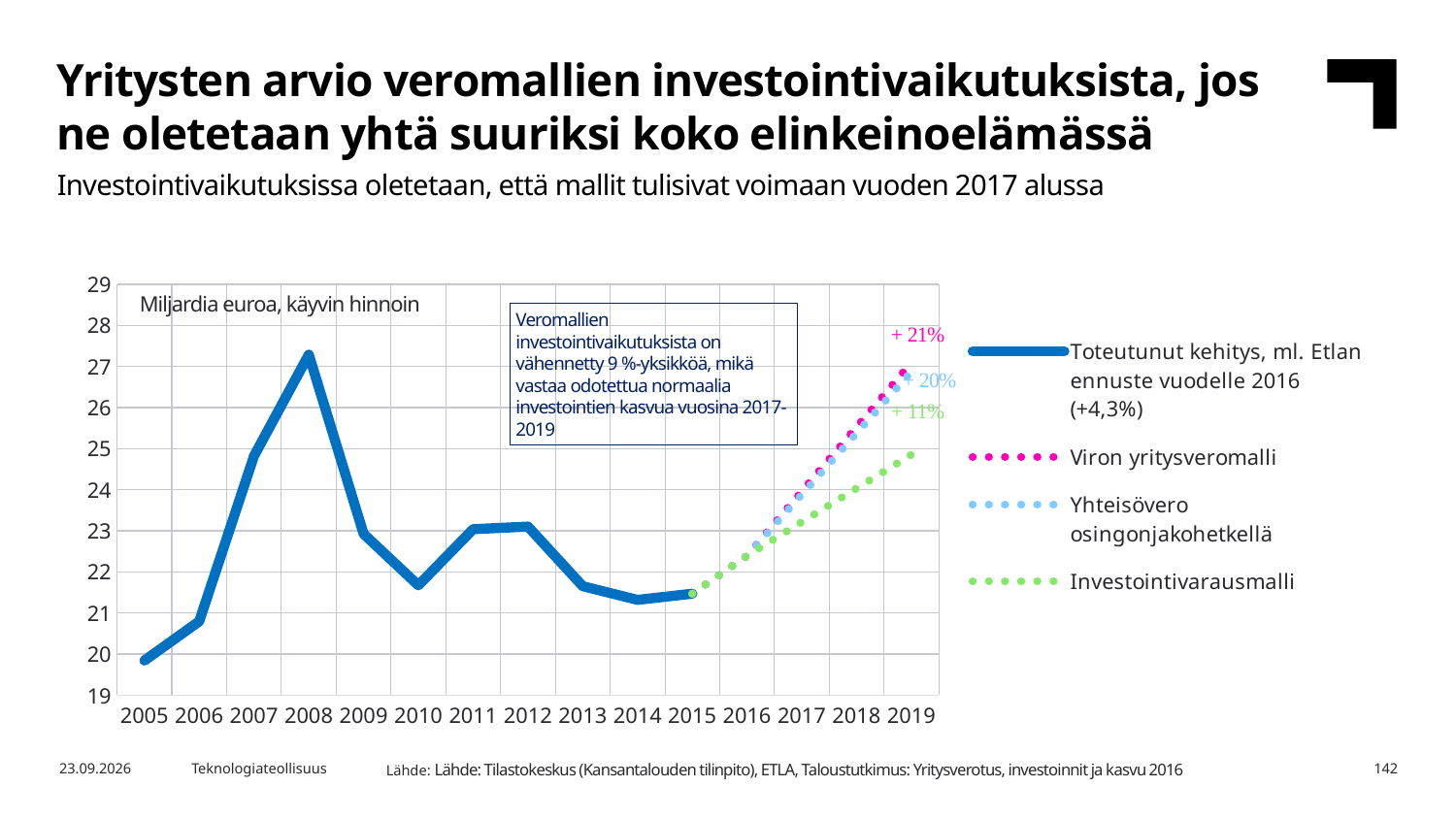
What percentage label is shown at the 2019 end of the Viron yritysveromalli line? + 21% Is the value of the Toteutunut kehitys line in 2008 greater or less than 27? greater How many series does the legend list? 4 Is the value of the Toteutunut kehitys line in 2005 greater or less than 20? less What percentage label is shown at the 2019 end of the Yhteisövero osingonjakohetkellä line? + 20% In which year does the Toteutunut kehitys line reach its highest value? 2008 In which year is the Toteutunut kehitys line at its lowest value? 2005 Does the Toteutunut kehitys line rise or fall from 2008 to 2010? fall What percentage label is shown at the 2019 end of the Investointivarausmalli line? + 11% Which series is higher in 2019, Viron yritysveromalli or Investointivarausmalli? Viron yritysveromalli What kind of chart is shown on the slide? line chart How many years are shown on the x axis? 15